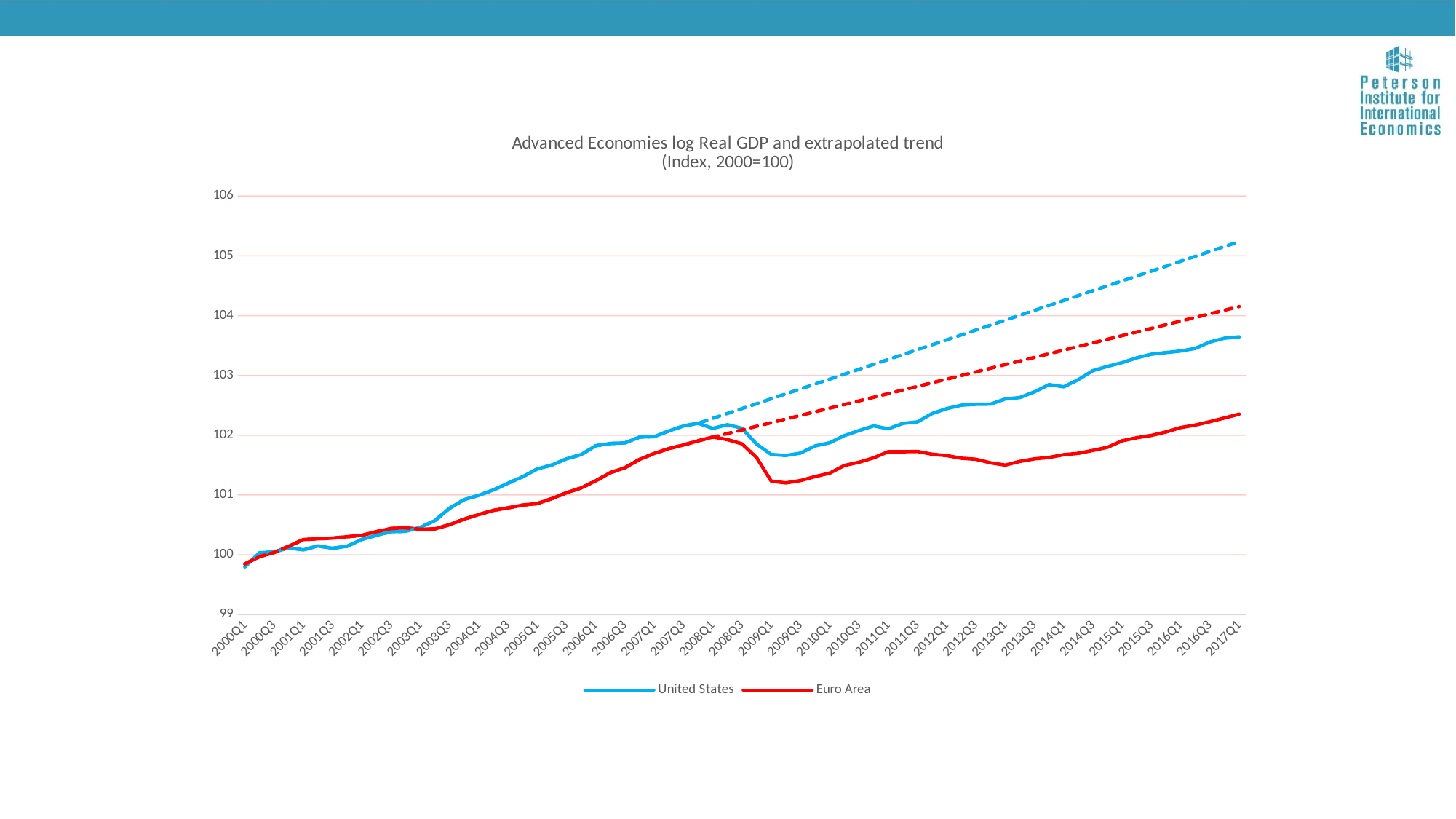
Is the value for Euro Area at 2013Q1 greater or less than 102? less Is the value for Euro Area at 2003Q1 greater or less than 101? less Is the value for United States at 2005Q1 greater or less than 101? greater At 2017Q1, which series has the higher value, United States or Euro Area? United States What kind of chart is shown on the slide? line chart Which colour is used for the Euro Area line? red Over the whole period from 2000Q1 to 2017Q1, does the United States line generally rise or fall? rise How many series does the legend list? 2 What is the title of the chart? Advanced Economies log Real GDP and extrapolated trend (Index, 2000=100)